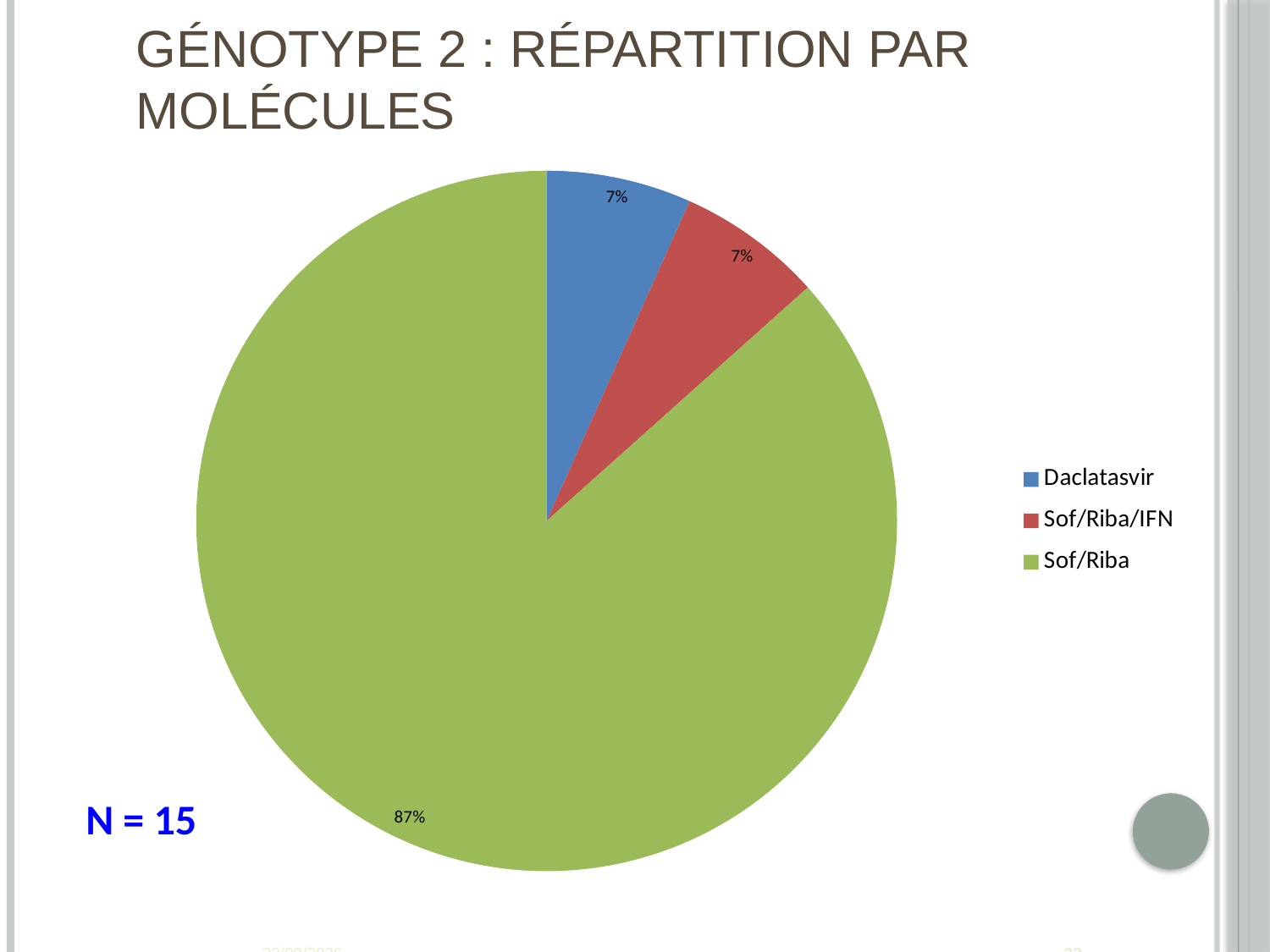
Which category has the largest slice of the pie? Sof/Riba What is the difference in percentage points between the Sof/Riba slice and the Daclatasvir slice? 80 What share of the pie does Sof/Riba/IFN represent? 7% What share of the pie does Sof/Riba represent? 87% What colour is the Sof/Riba slice? green Which is larger, the Sof/Riba slice or the Sof/Riba/IFN slice? Sof/Riba What kind of chart is shown on the slide? pie chart What share of the pie does Daclatasvir represent? 7% What is the title of the slide containing the chart? Génotype 2 : Répartition par molécules What is the value of N shown on the slide? 15 How many entries does the legend list? 3 How many categories does the pie chart show? 3